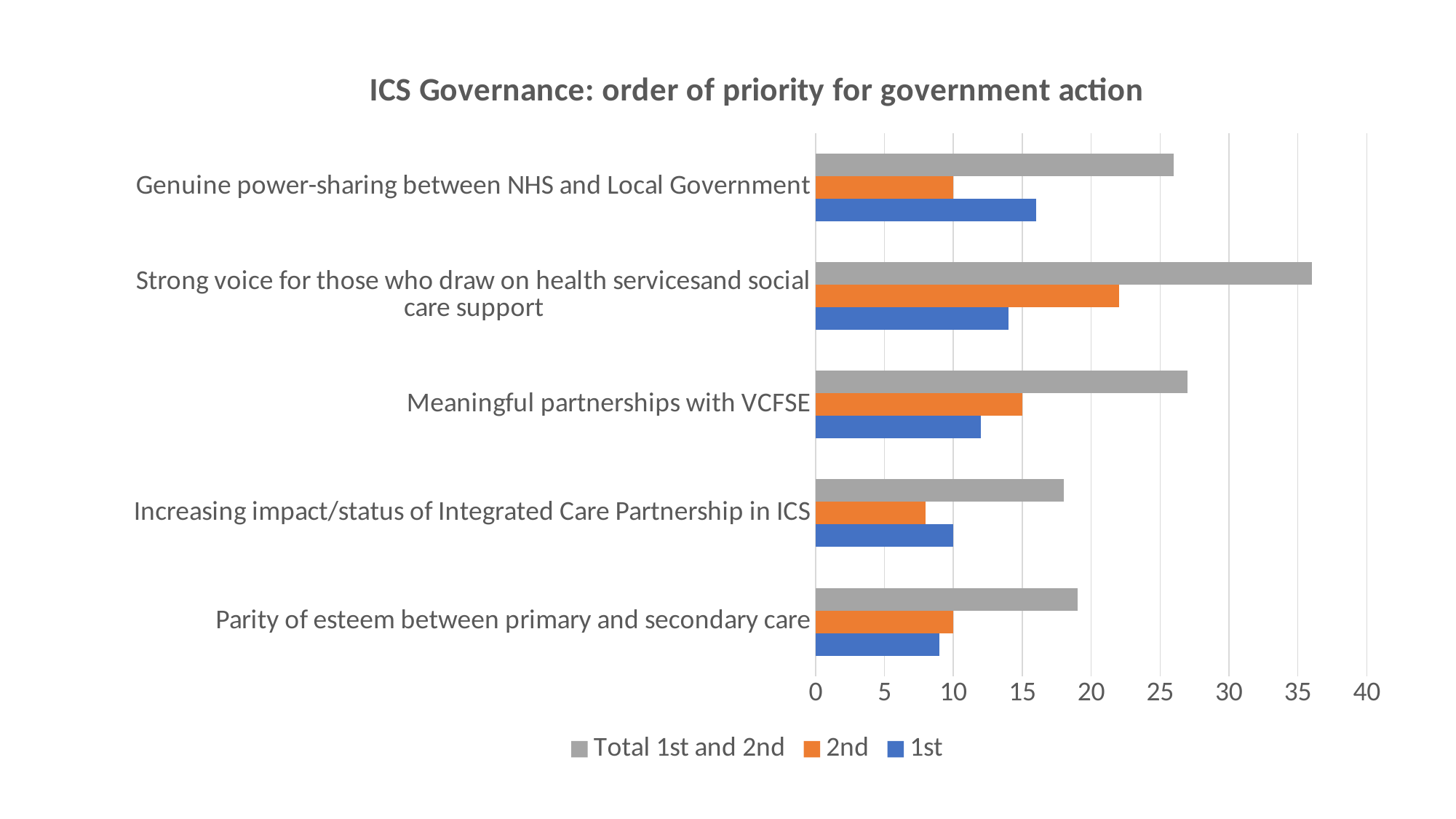
What is the title of the chart? ICS Governance: order of priority for government action Is the '2nd' value for 'Increasing impact/status of Integrated Care Partnership in ICS' greater or less than 10? less What kind of chart is shown on the slide? bar chart For the '2nd' series, which is larger: 'Strong voice for those who draw on health services and social care support' or 'Meaningful partnerships with VCFSE'? Strong voice for those who draw on health services and social care support Which category has the highest value for the '2nd' series? Strong voice for those who draw on health services and social care support How many series does the legend list? 3 Is the 'Total 1st and 2nd' value for 'Meaningful partnerships with VCFSE' greater or less than 25? greater Is the 'Total 1st and 2nd' value for 'Genuine power-sharing between NHS and Local Government' greater or less than 30? less Which category has the highest value for the 'Total 1st and 2nd' series? Strong voice for those who draw on health services and social care support What colour represents the '1st' series in the legend? blue How many categories are plotted on the chart? 5 What is the '2nd' value for 'Meaningful partnerships with VCFSE'? 15